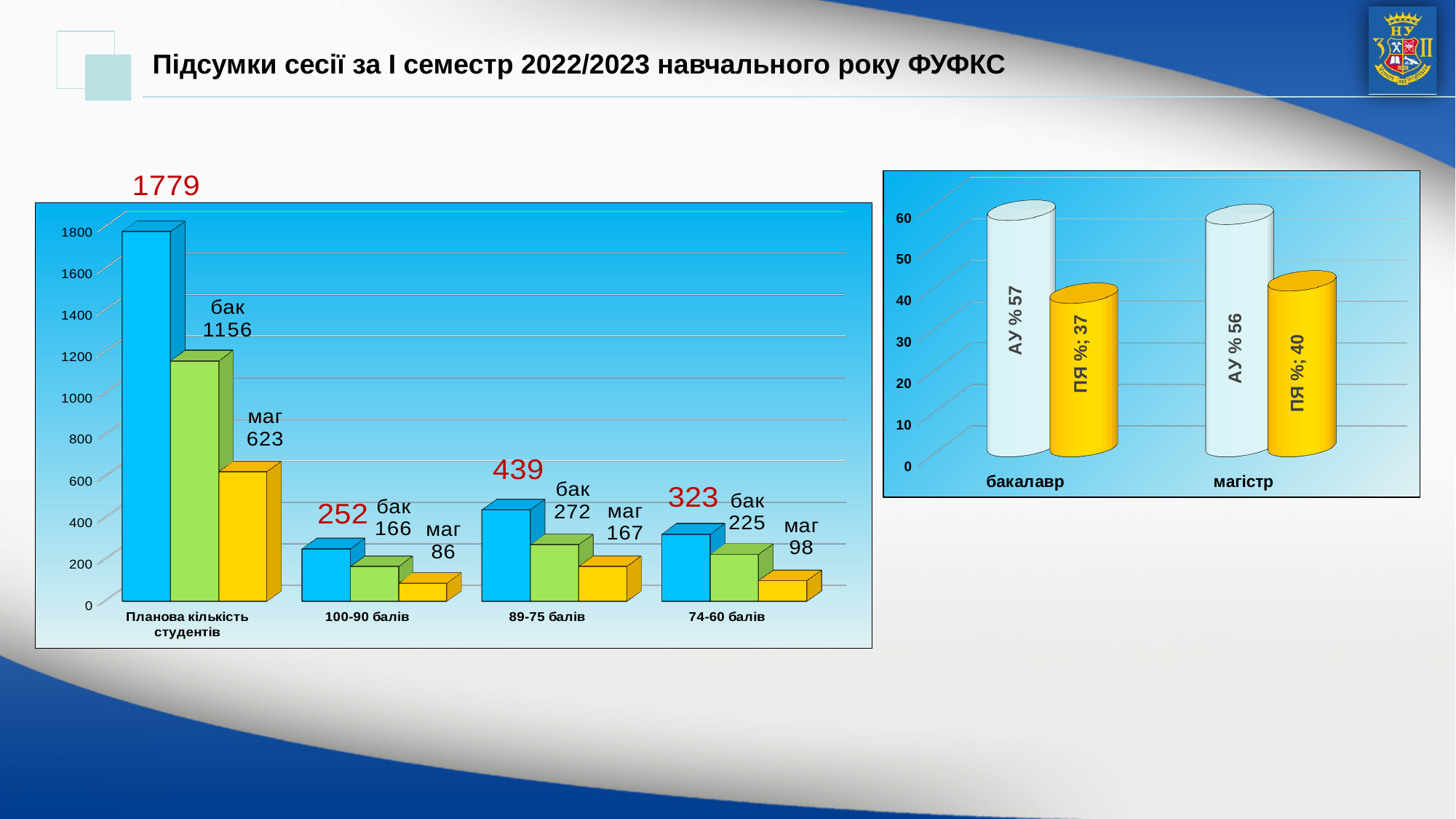
In the left chart, which category has the lowest 'маг' value? 100-90 балів In the right chart, what is the 'АУ %' value for 'бакалавр'? 57 In the left chart, which is larger: the 'бак' value for '74-60 балів' or the 'бак' value for '100-90 балів'? 74-60 балів In the left chart, what is the 'маг' value for '100-90 балів'? 86 How many categories are shown on the x axis of the left chart? 4 In the right chart, what is the difference between the 'ПЯ %' values for 'магістр' and 'бакалавр'? 3 In the left chart, what is the total value shown for 'Планова кількість студентів'? 1779 In the left chart, what is the 'маг' value for '74-60 балів'? 98 In the right chart, what is the 'ПЯ %' value for 'магістр'? 40 In the left chart, what is the 'бак' value for '89-75 балів'? 272 In the left chart, what is the difference between the 'бак' and 'маг' values for 'Планова кількість студентів'? 533 In the left chart, which score category (excluding the planned total) has the highest total value? 89-75 балів